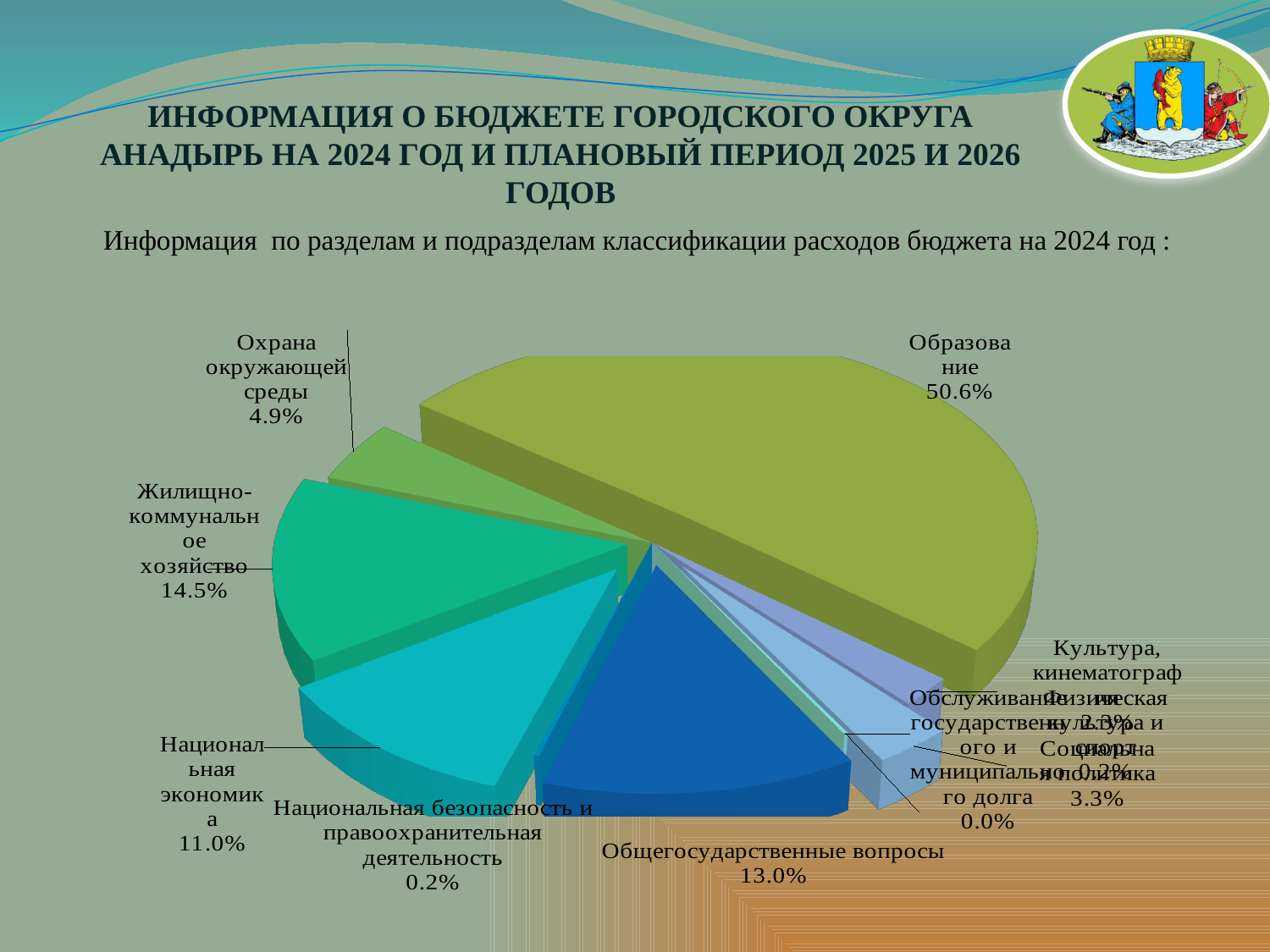
What is the difference in percentage points between Жилищно-коммунальное хозяйство and Национальная экономика? 3.5 What percentage is shown for Общегосударственные вопросы? 13.0% What share of expenditure is shown for Жилищно-коммунальное хозяйство? 14.5% Which section has the largest share of the pie? Образование What kind of chart is shown on the slide? pie chart Which is larger, the share for Общегосударственные вопросы or for Охрана окружающей среды? Общегосударственные вопросы What share is shown for Национальная экономика? 11.0% What percentage is shown for Обслуживание государственного и муниципального долга? 0.0% What share is shown for Национальная безопасность и правоохранительная деятельность? 0.2% Which section has the smallest share of the pie? Обслуживание государственного и муниципального долга What share of the 2024 budget expenditure goes to Образование? 50.6% What percentage is shown for Охрана окружающей среды? 4.9%